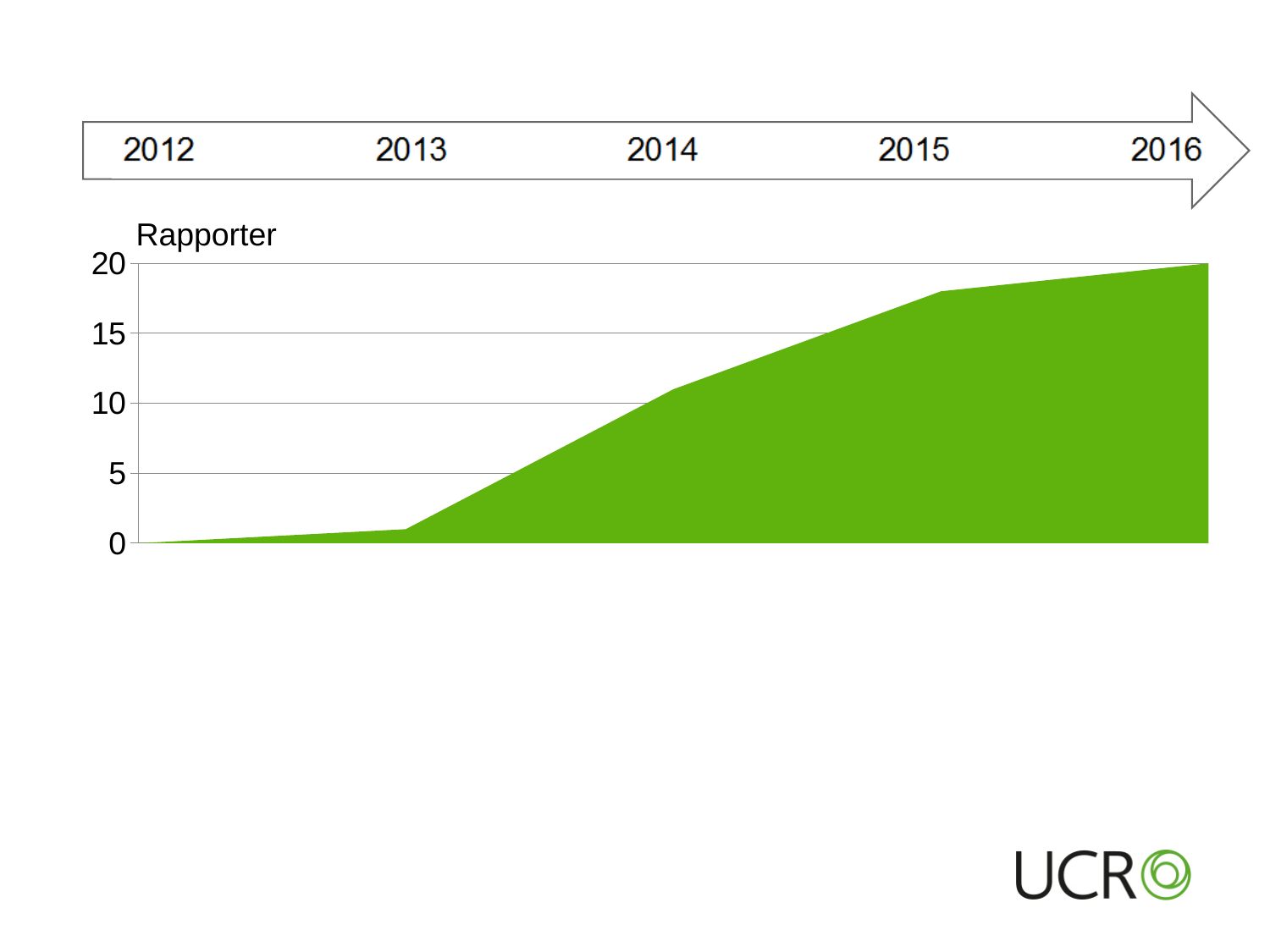
Is the value for 2014 greater or less than 15? less Is the value for 2013 greater or less than 5? less Which year has the lowest value? 2012 Which year has the highest value? 2016 What kind of chart is shown on the slide? area chart Do the values rise or fall from 2012 to 2016? rise Which is larger, the value for 2014 or the value for 2015? 2015 Is the value for 2015 greater or less than 15? greater What colour is the filled area in the chart? green What label is shown on the vertical axis of the chart? Rapporter How many years are shown along the x axis? 5